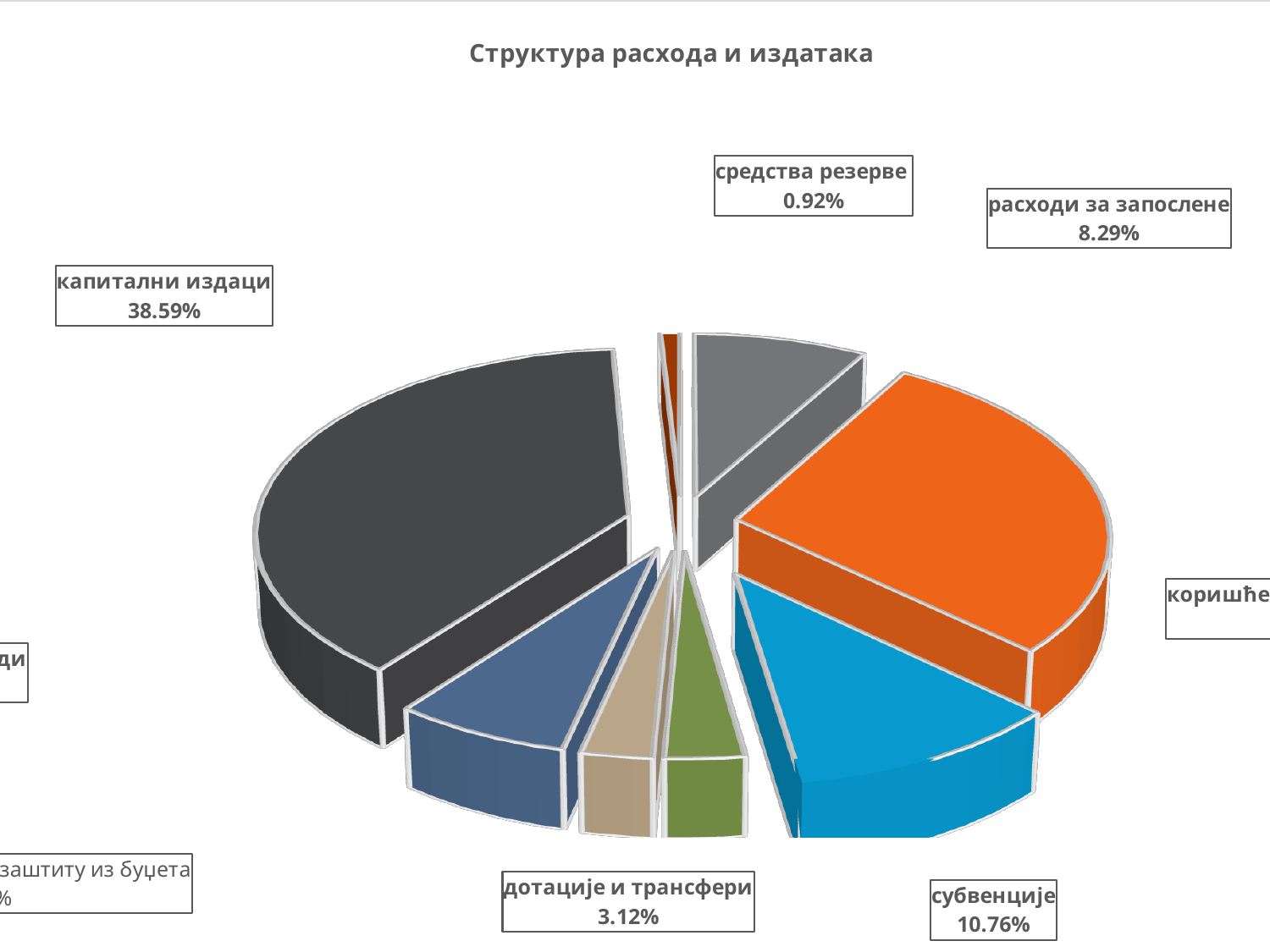
What share does капитални издаци have in the pie chart? 38.59% What is the value shown for субвенције? 10.76% What share is shown for средства резерве? 0.92% What type of chart is shown on the slide? pie chart What is the title of the chart? Структура расхода и издатака Which category has the smallest slice of the pie? средства резерве What is the value for дотације и трансфери? 3.12% What percentage is labelled for расходи за запослене? 8.29% What is the difference between the shares of расходи за запослене and дотације и трансфери? 5.17% Which is larger, субвенције or расходи за запослене? субвенције Which category has the largest slice of the pie? капитални издаци What is the difference between the shares of капитални издаци and субвенције? 27.83%